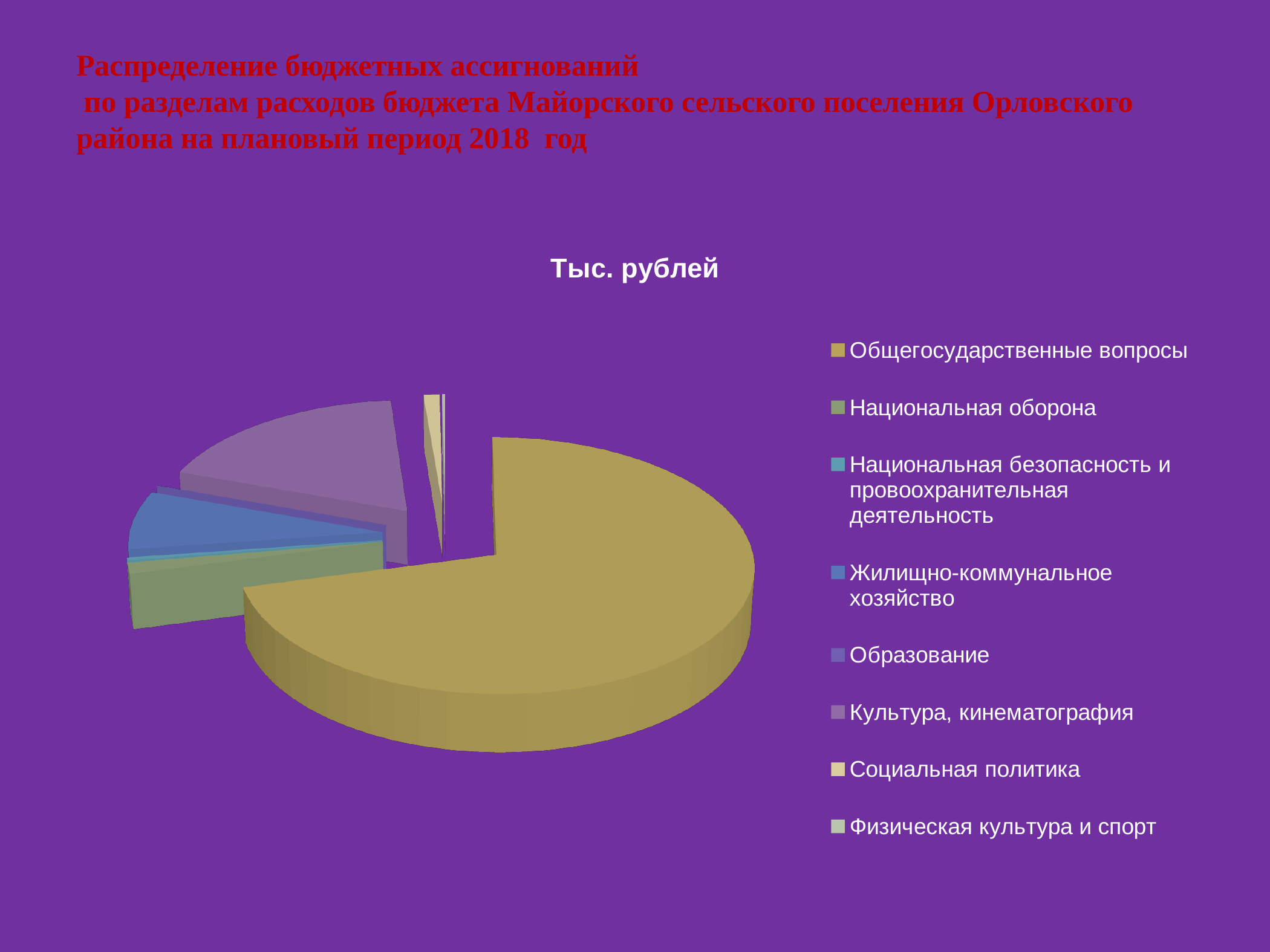
Which slice is larger: Общегосударственные вопросы or Культура, кинематография? Общегосударственные вопросы What kind of chart is shown on the slide? pie chart Which slice is larger: Жилищно-коммунальное хозяйство or Социальная политика? Жилищно-коммунальное хозяйство What is the last category listed in the legend of the pie chart? Физическая культура и спорт Which category has the largest slice of the pie chart? Общегосударственные вопросы Which slice is larger: Культура, кинематография or Национальная оборона? Культура, кинематография What is the title shown above the pie chart? Тыс. рублей How many categories does the legend of the pie chart list? 8